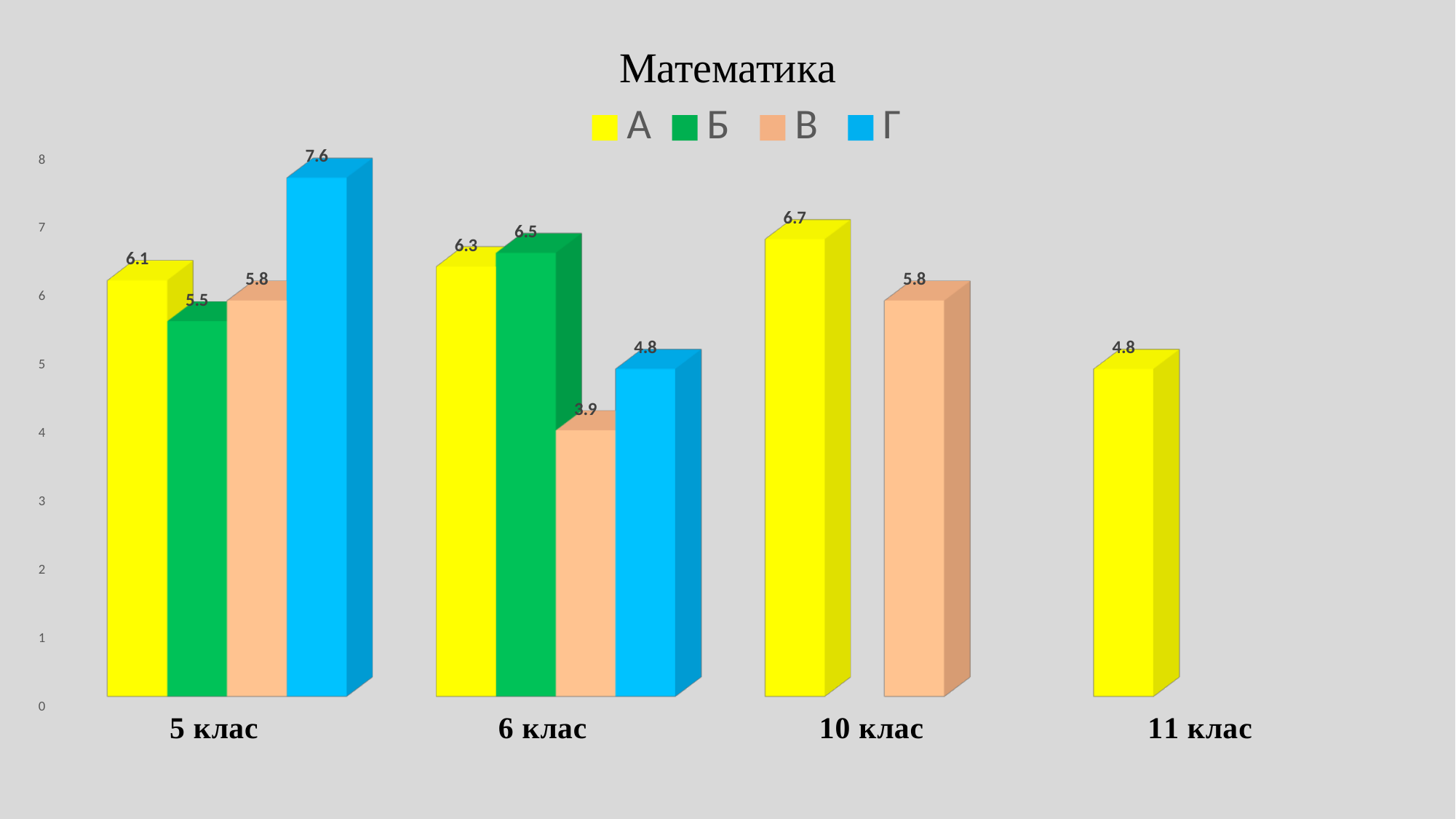
Which is larger: the value for Б in 5 клас or the value for Б in 6 клас? Б in 6 клас How many series does the legend list? 4 What is the value for series А in 11 клас? 4.8 What is the value for series В in 6 клас? 3.9 What is the value for series Г in 5 клас? 7.6 Which series has the lowest value in 6 клас? В What is the value for series А in 10 клас? 6.7 How many categories are shown on the x axis? 4 What is the difference between the values for Г and Б in 5 клас? 2.1 What is the title of the chart? Математика What kind of chart is shown on the slide? bar chart Which series has the highest value in 5 клас? Г